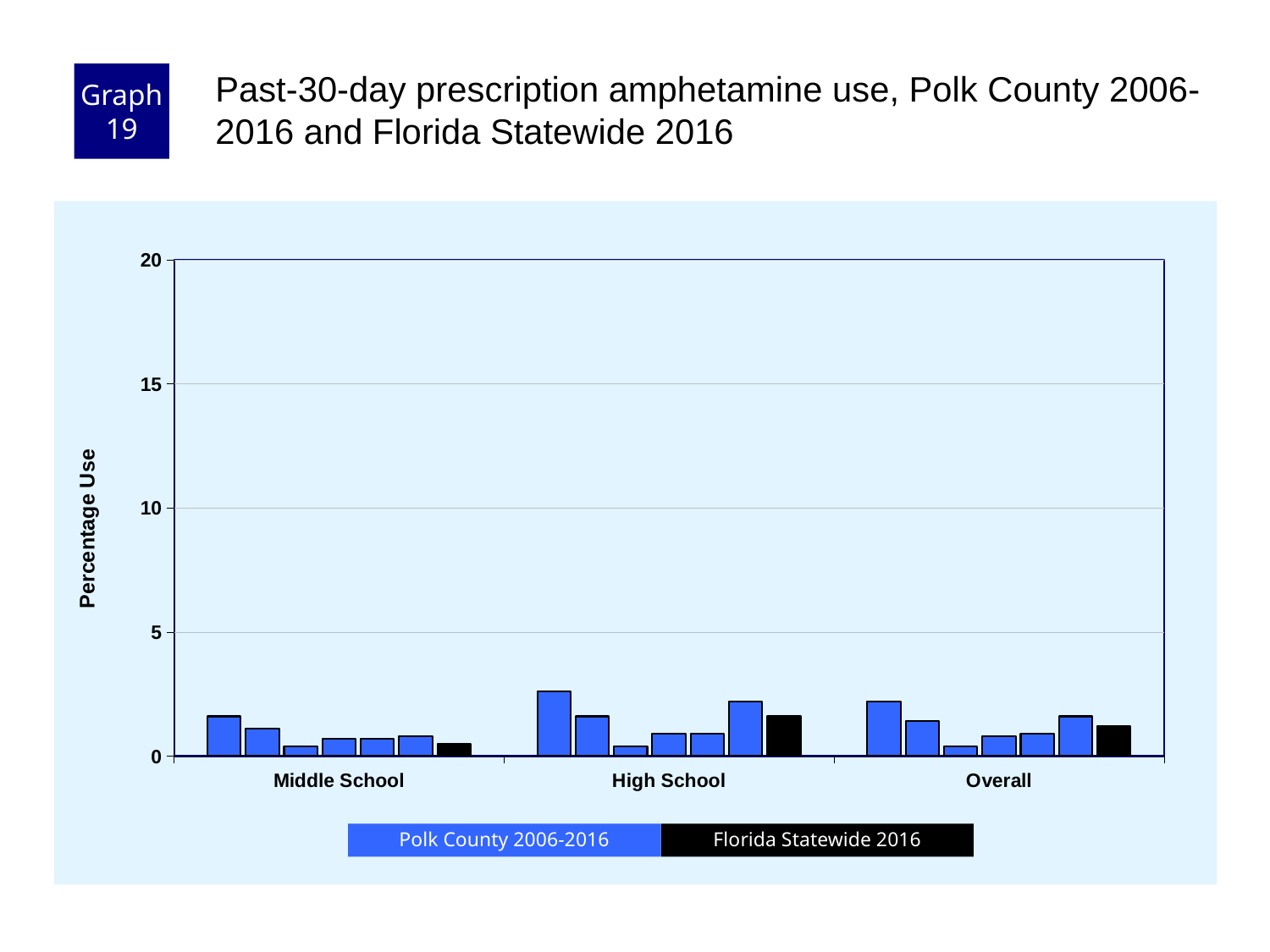
How many series does the legend list? 2 Which category has the lowest Florida Statewide 2016 value? Middle School Which category contains the tallest bar in the chart? High School How many categories are shown on the x axis? 3 What kind of chart is shown on the slide? bar chart What is the label on the y axis? Percentage Use How many bars are plotted in the Middle School group? 7 What is the title of the chart? Past-30-day prescription amphetamine use, Polk County 2006-2016 and Florida Statewide 2016 Is the Florida Statewide 2016 value for Overall greater or less than 10? less Is the Florida Statewide 2016 value larger for High School or for Middle School? High School Is the Florida Statewide 2016 value for High School greater or less than 5? less Is the tallest Polk County 2006-2016 bar for High School greater or less than 5? less